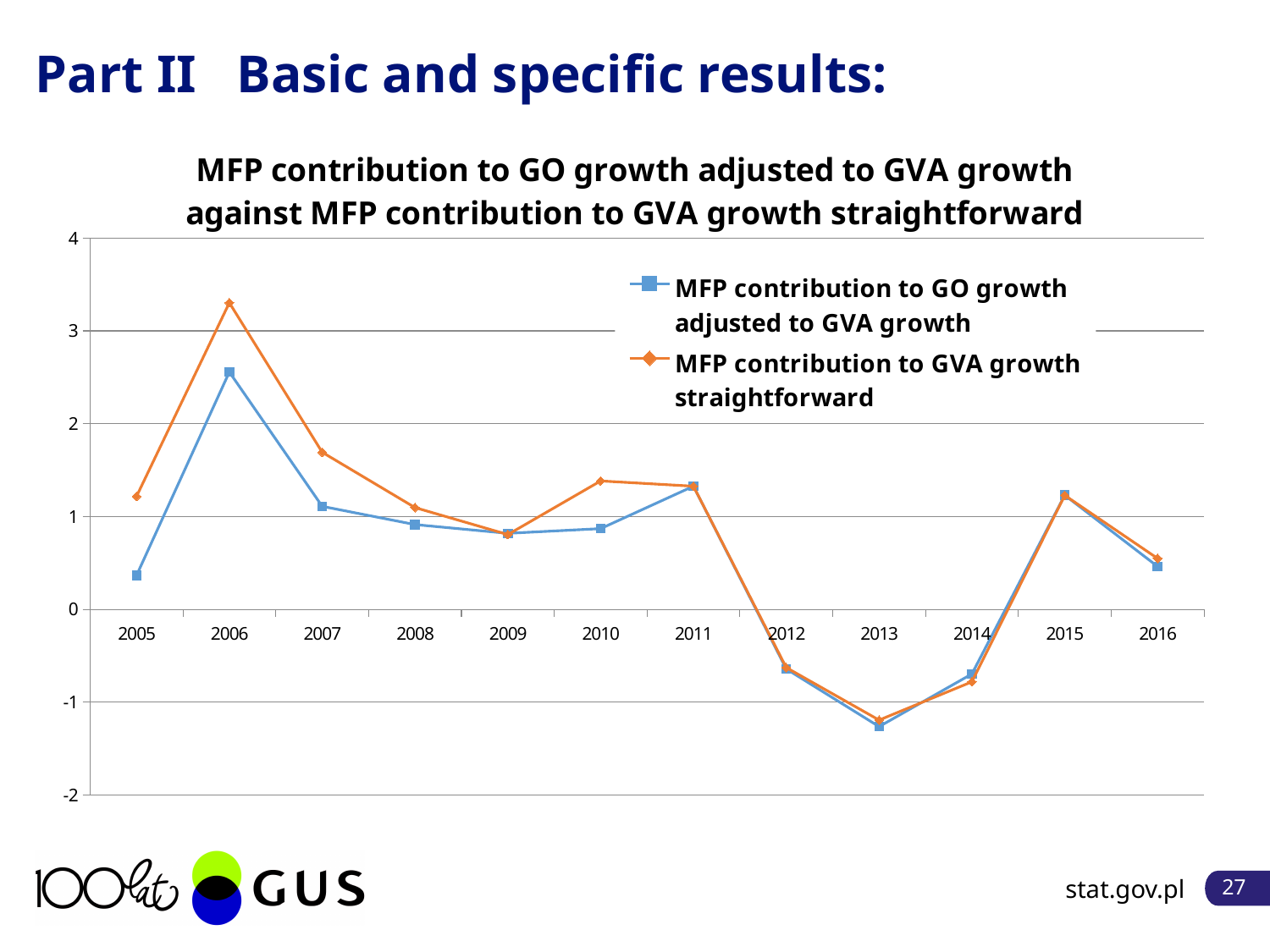
Is the 2006 value for 'MFP contribution to GO growth adjusted to GVA growth' greater or less than 3? less In which year does the 'MFP contribution to GVA growth straightforward' series reach its highest value? 2006 In 2007, which series has the higher value? MFP contribution to GVA growth straightforward Does the 'MFP contribution to GO growth adjusted to GVA growth' series rise or fall from 2011 to 2013? fall What colour is the line for 'MFP contribution to GO growth adjusted to GVA growth'? blue In which year does the 'MFP contribution to GO growth adjusted to GVA growth' series reach its highest value? 2006 How many series does the legend list? 2 How many years are plotted along the x axis? 12 What kind of chart is shown on the slide? line chart Is the 2005 value for 'MFP contribution to GO growth adjusted to GVA growth' greater or less than 1? less Is the 2006 value for 'MFP contribution to GVA growth straightforward' greater or less than 3? greater In which year does the 'MFP contribution to GVA growth straightforward' series reach its lowest value? 2013